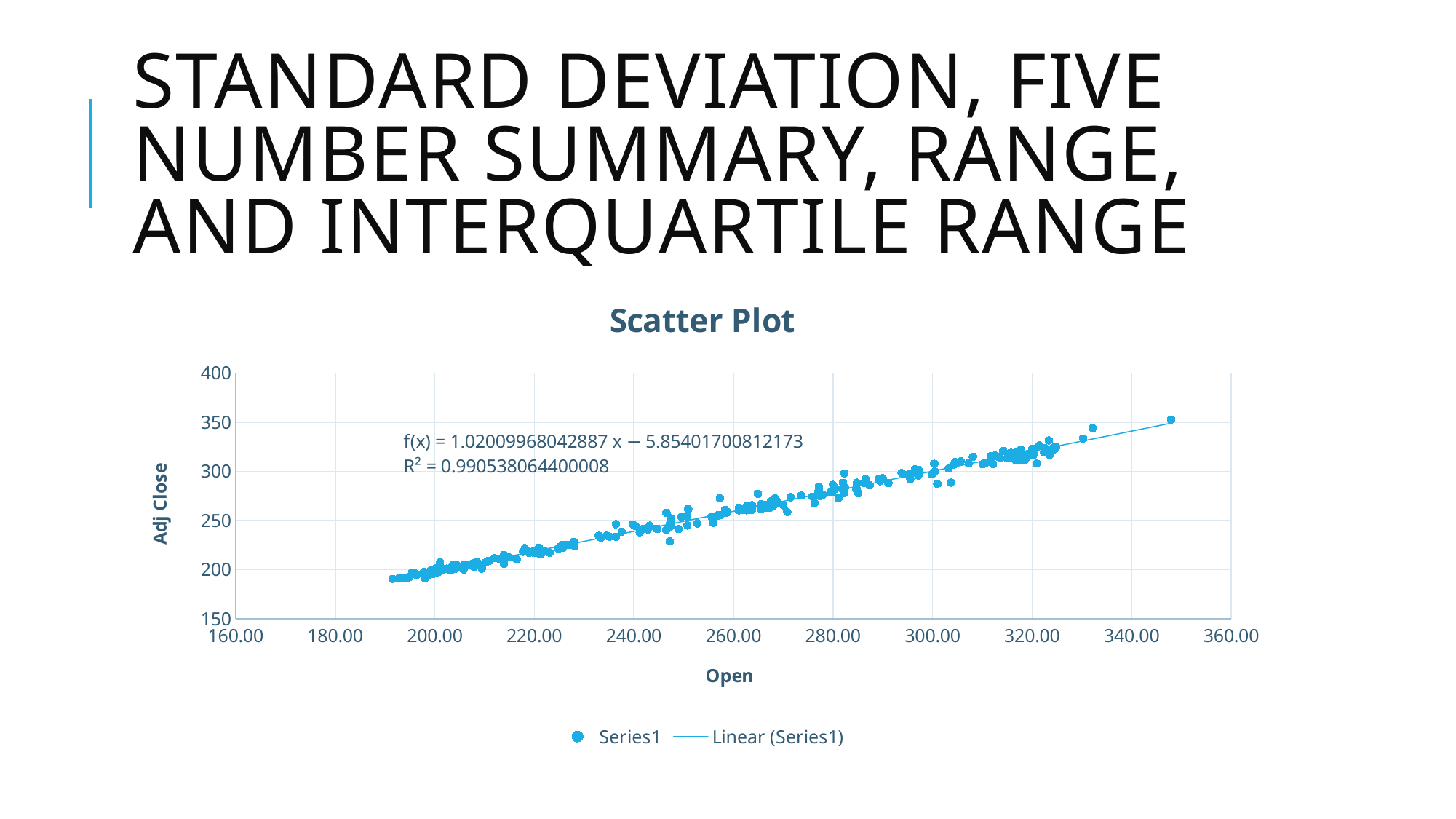
Do the Adj Close values rise or fall as Open increases along the x axis? Rise What is the label of the y axis? Adj Close How many entries does the legend list? 2 What is the equation of the linear trendline shown on the chart? f(x) = 1.02009968042887 x − 5.85401700812173 What is the R² value shown for the linear trendline? R² = 0.990538064400008 What is the label of the x axis? Open What is the slope of the linear trendline shown on the chart? 1.02009968042887 What is the maximum value shown on the y axis? 400 Is the Adj Close value of the rightmost point (at the highest Open value) greater or less than 300? greater What is the title of the chart? Scatter Plot Is the Adj Close value of the leftmost point (at the lowest Open value) greater or less than 200? less What kind of chart is shown on the slide? Scatter plot